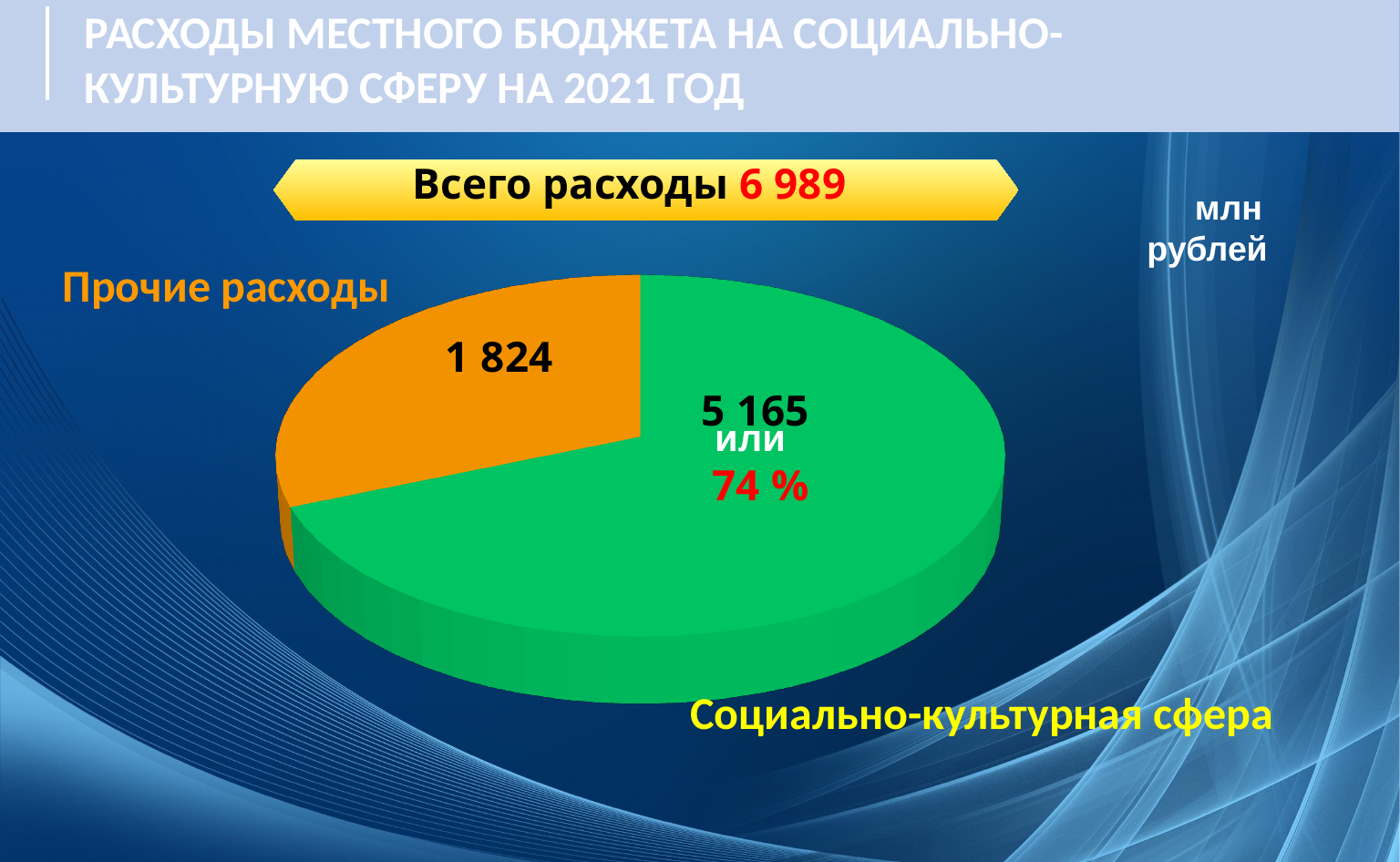
Which slice is the smallest? Прочие расходы What is the value for Прочие расходы? 1 824 What type of chart is shown on the slide? pie chart What is the difference between Социально-культурная сфера and Прочие расходы? 3 341 In what units are the values on the slide given? млн рублей What is the value for Социально-культурная сфера? 5 165 What share of the pie does Социально-культурная сфера represent? 74 % What is the total of all expenses shown on the slide (Всего расходы)? 6 989 What colour is the Прочие расходы slice? orange How many slices does the pie chart have? 2 Which is larger, Прочие расходы or Социально-культурная сфера? Социально-культурная сфера Which slice is the largest? Социально-культурная сфера